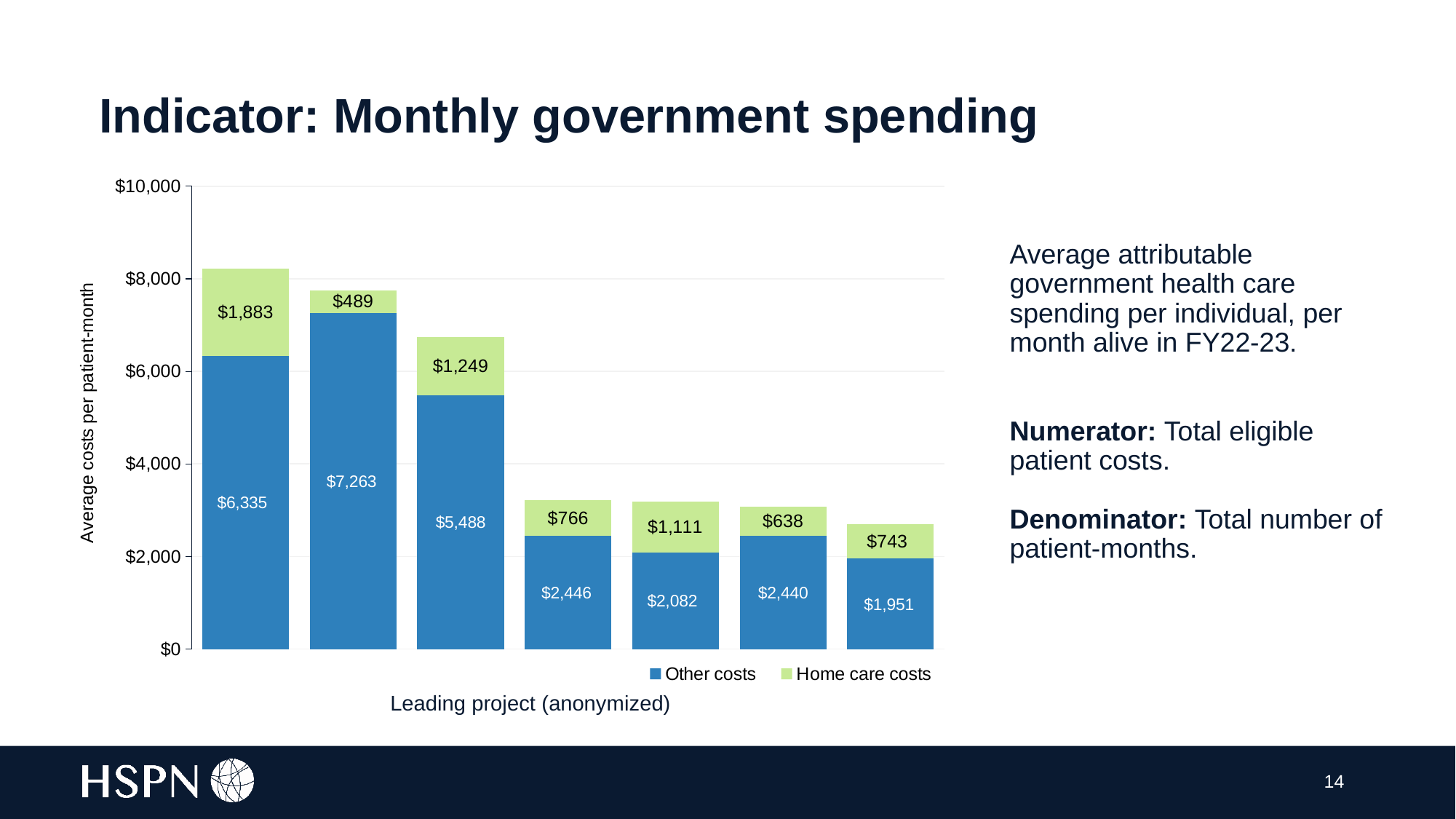
How many bars (projects) are plotted in the chart? 7 How many series does the legend list? 2 What is the title of the vertical axis? Average costs per patient-month What kind of chart is shown on the slide? Stacked bar chart What is the difference between the Other costs of the first bar and the third bar from the left? $847 Which bar has the lowest Home care costs value? The second bar from the left ($489) What is the Other costs value for the second bar from the left? $7,263 Which bar has the highest Other costs value? The second bar from the left ($7,263) Which has the larger Home care costs value: the fifth bar or the sixth bar from the left? The fifth bar ($1,111) What is the total height (Other costs plus Home care costs) of the first bar from the left? $8,218 Is the total of the first bar from the left greater or less than $8,000? greater What is the Home care costs value for the third bar from the left? $1,249